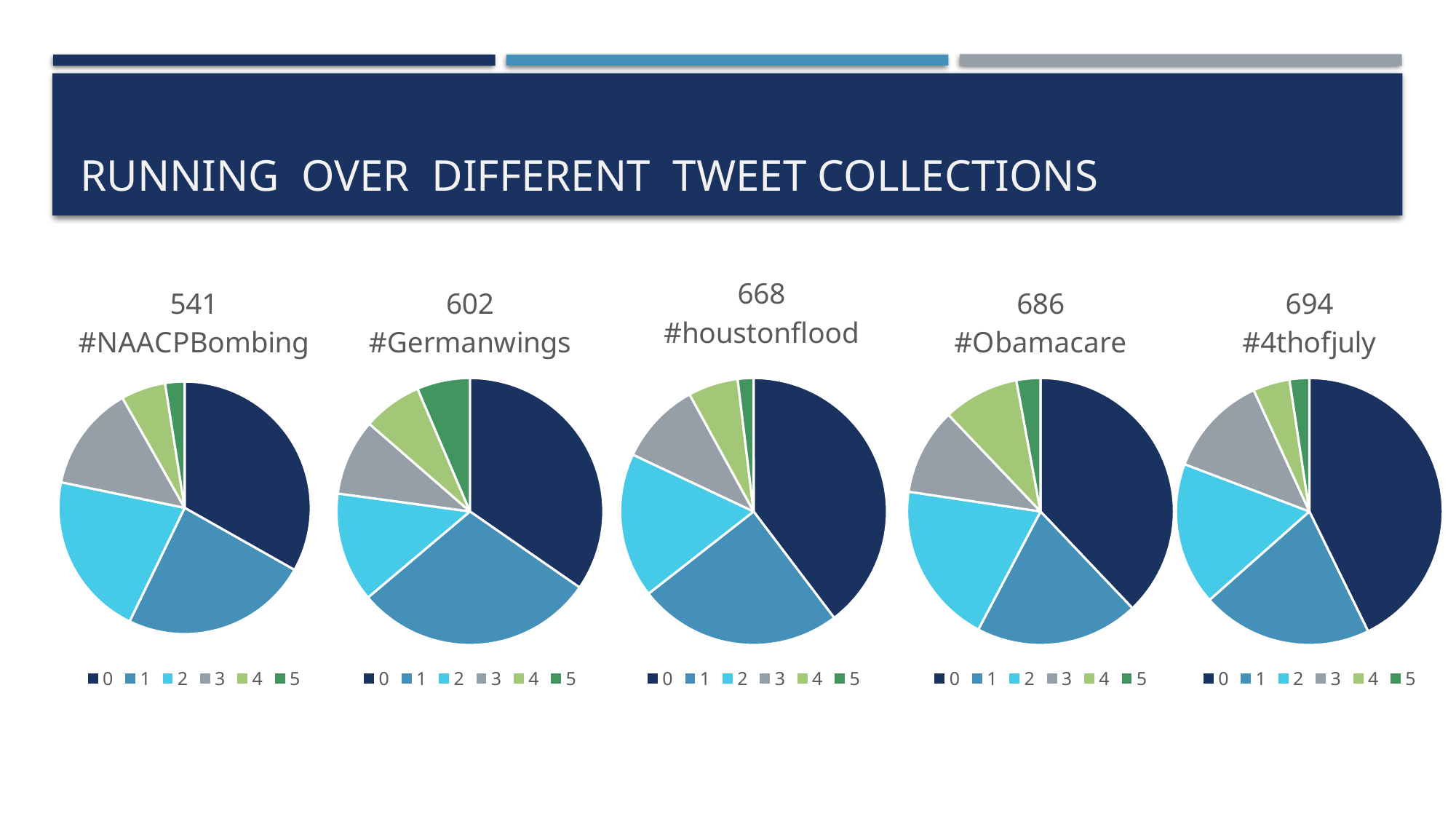
In the "602 #Germanwings" chart, which category has the smallest slice? 5 How many pie charts are shown on the slide? 5 What kind of chart is the "541 #NAACPBombing" chart? pie chart In the "694 #4thofjuly" chart, which category has the smallest slice? 5 In the "686 #Obamacare" chart, which slice is larger, category 3 or category 5? 3 How many slices does the "668 #houstonflood" pie chart have? 6 What is the title of the slide? RUNNING OVER DIFFERENT TWEET COLLECTIONS In the "686 #Obamacare" chart, which category has the largest slice? 0 How many entries does the legend of the "602 #Germanwings" chart list? 6 In the "694 #4thofjuly" chart, which slice is larger, category 0 or category 2? 0 In the "541 #NAACPBombing" chart, which category has the largest slice? 0 In the "668 #houstonflood" chart, which slice is larger, category 1 or category 4? 1